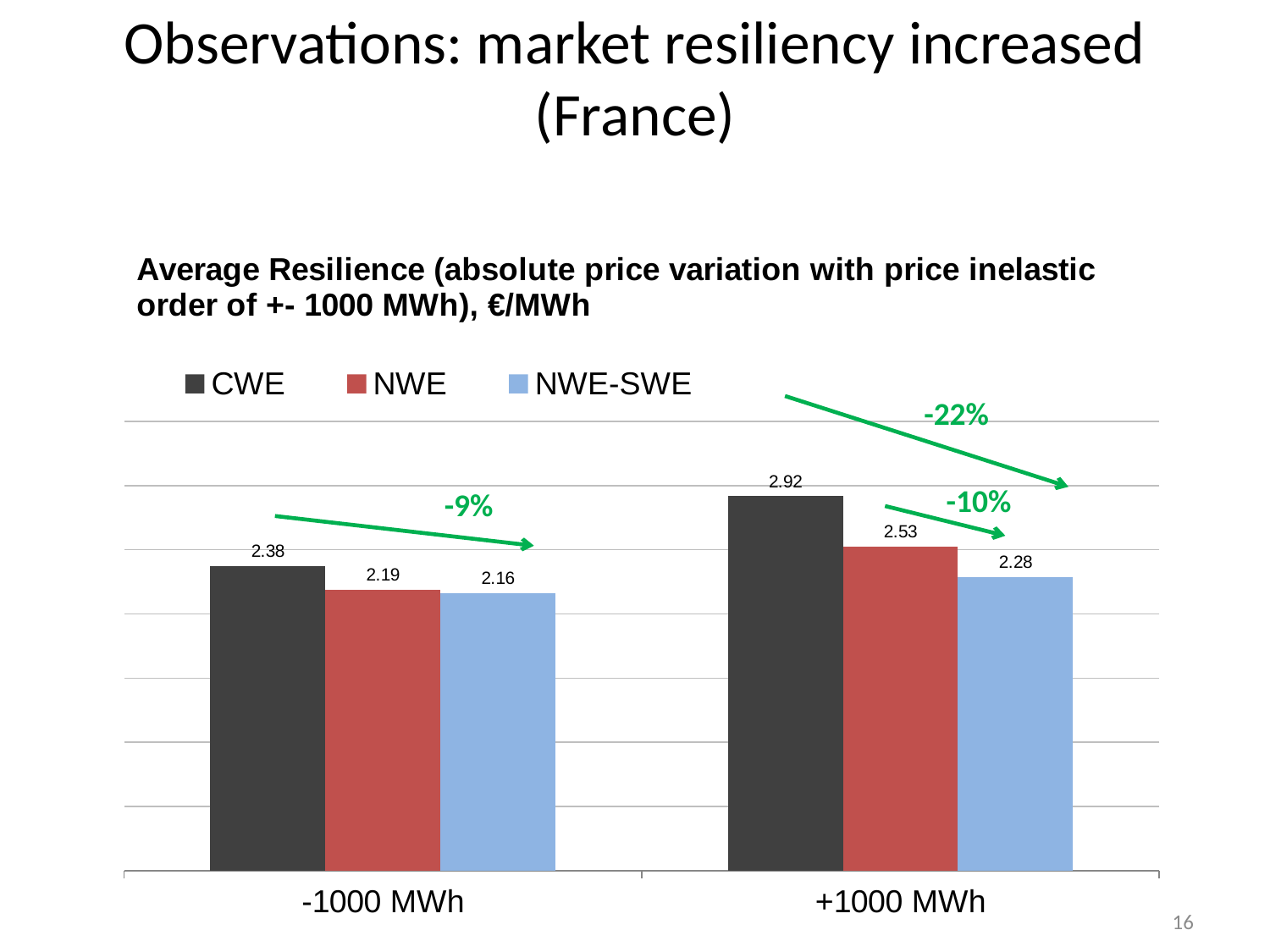
What kind of chart is shown on the slide? bar chart Which series has the highest value at +1000 MWh? CWE What is the value for NWE-SWE at +1000 MWh? 2.28 What percentage change is annotated above the +1000 MWh group? -22% How many categories are shown on the x axis? 2 What is the value for NWE at +1000 MWh? 2.53 How many series does the legend list? 3 What is the difference between CWE and NWE-SWE at +1000 MWh? 0.64 Which is larger: NWE at -1000 MWh or NWE at +1000 MWh? NWE at +1000 MWh Which series has the lowest value at -1000 MWh? NWE-SWE What is the value for CWE at -1000 MWh? 2.38 What is the difference between the CWE values at +1000 MWh and -1000 MWh? 0.54